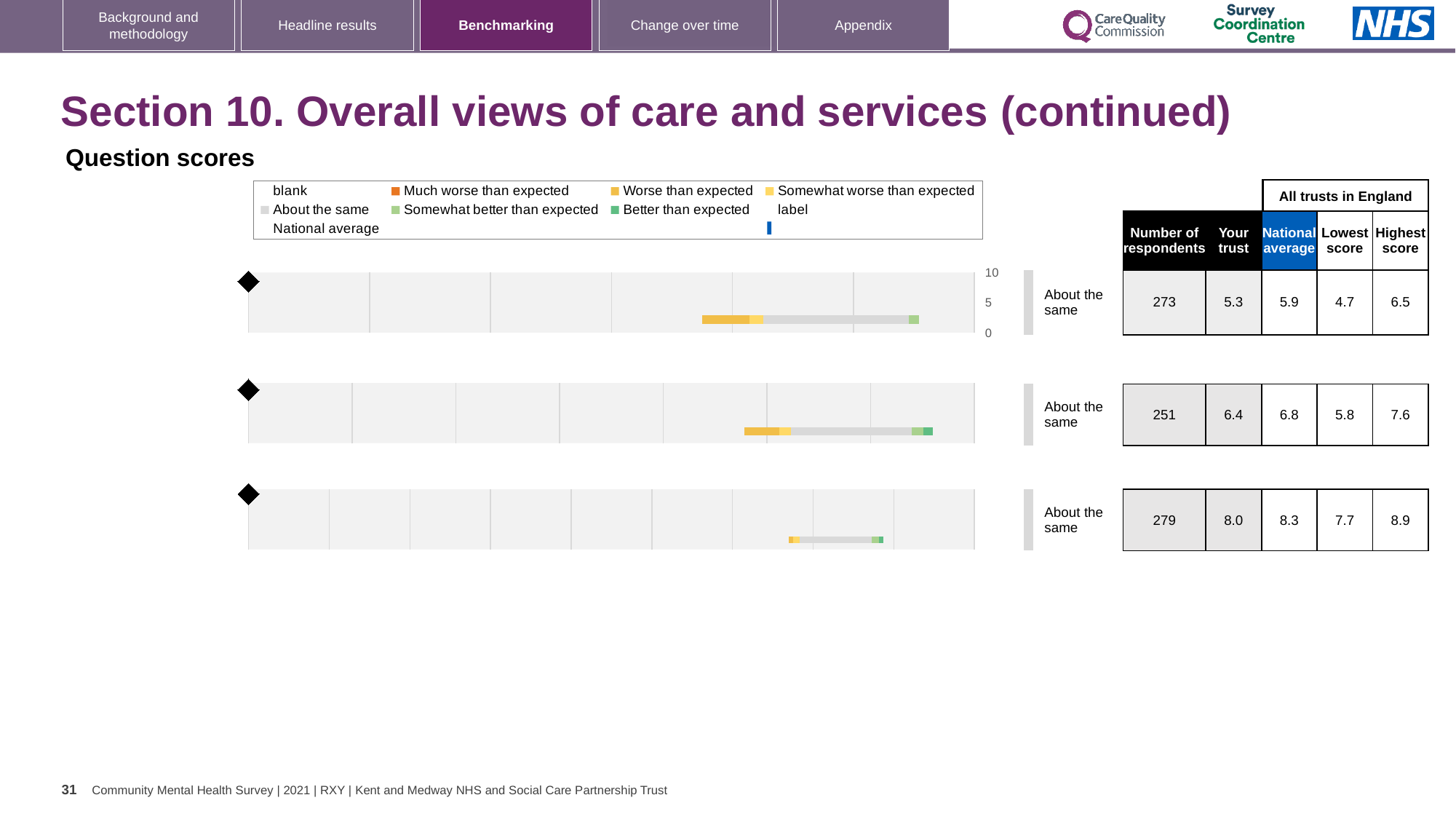
For the top chart, what is the national average score? 5.9 For the top chart, what is the 'Your trust' score shown in the table? 5.3 For the bottom chart, what is the highest score among all trusts in England? 8.9 For the middle chart, how many respondents are listed? 251 For the top chart, how much higher is the national average than the 'Your trust' score? 0.6 What benchmark category is shown next to the middle chart? About the same What kind of chart is used for the benchmarking displays on this slide? Bar chart For the bottom chart, which is larger: the 'Your trust' score or the national average? National average For the middle chart, what is the lowest score among all trusts in England? 5.8 How many benchmarking charts are shown on the slide? 3 For the bottom chart, what is the difference between the highest score and the lowest score? 1.2 Which chart (top, middle or bottom) has the highest 'Your trust' score? Bottom chart